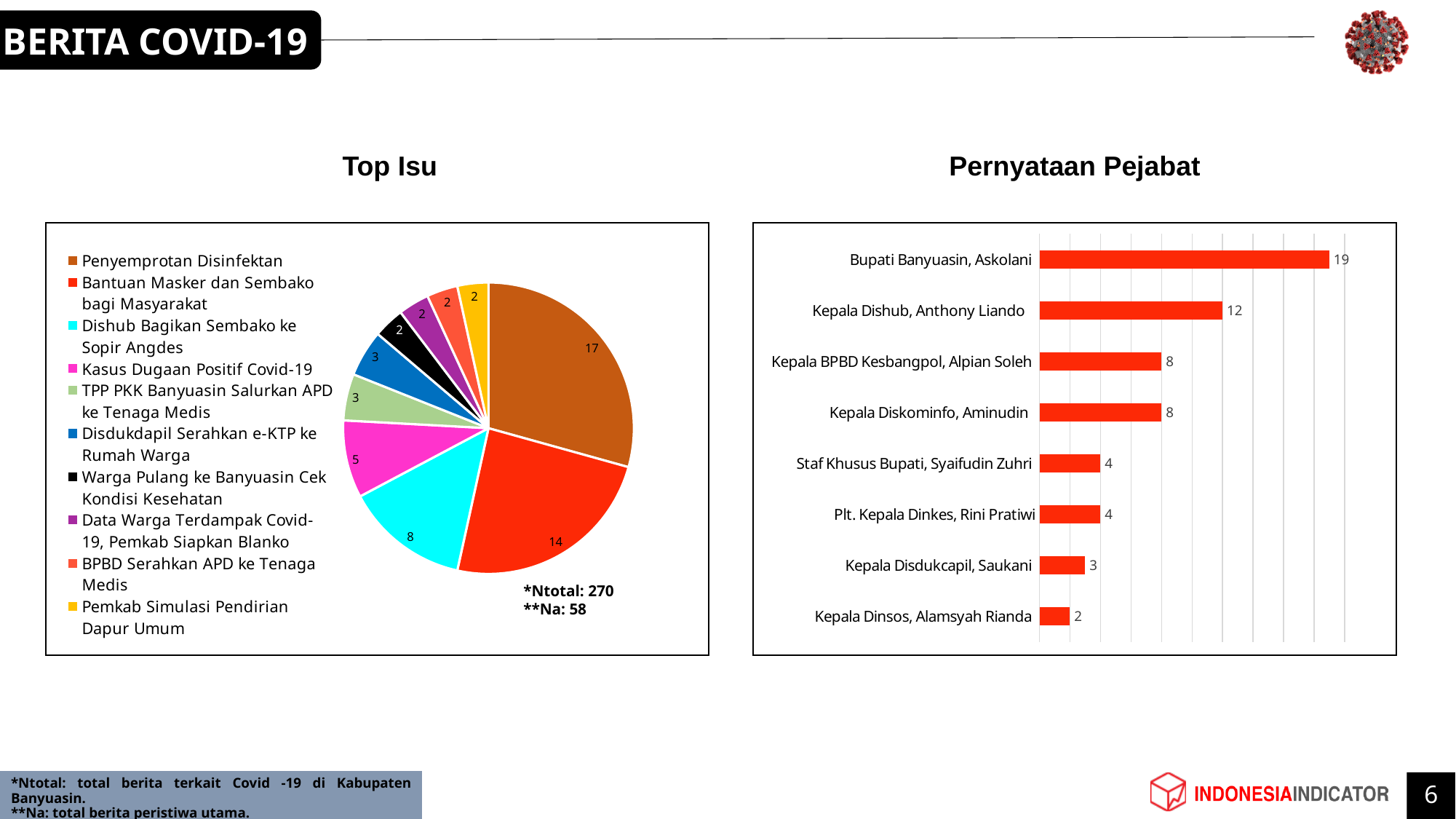
In the Pernyataan Pejabat chart, what is the difference between Bupati Banyuasin, Askolani and Kepala Diskominfo, Aminudin? 11 In the Top Isu pie chart, what is the value for Dishub Bagikan Sembako ke Sopir Angdes? 8 In the Pernyataan Pejabat chart, which official has the lowest value? Kepala Dinsos, Alamsyah Rianda In the Pernyataan Pejabat chart, which official has the highest value? Bupati Banyuasin, Askolani What type of chart is the Pernyataan Pejabat chart? bar chart In the Top Isu pie chart, what is the difference between Bantuan Masker dan Sembako bagi Masyarakat and Kasus Dugaan Positif Covid-19? 9 In the Pernyataan Pejabat chart, how many officials are shown? 8 In the Top Isu pie chart, which category has the largest slice? Penyemprotan Disinfektan In the Pernyataan Pejabat chart, what is the value for Kepala Dishub, Anthony Liando? 12 In the Top Isu pie chart, how many categories does the legend list? 10 What type of chart is the Top Isu chart? pie chart In the Top Isu pie chart, what is the value for Penyemprotan Disinfektan? 17